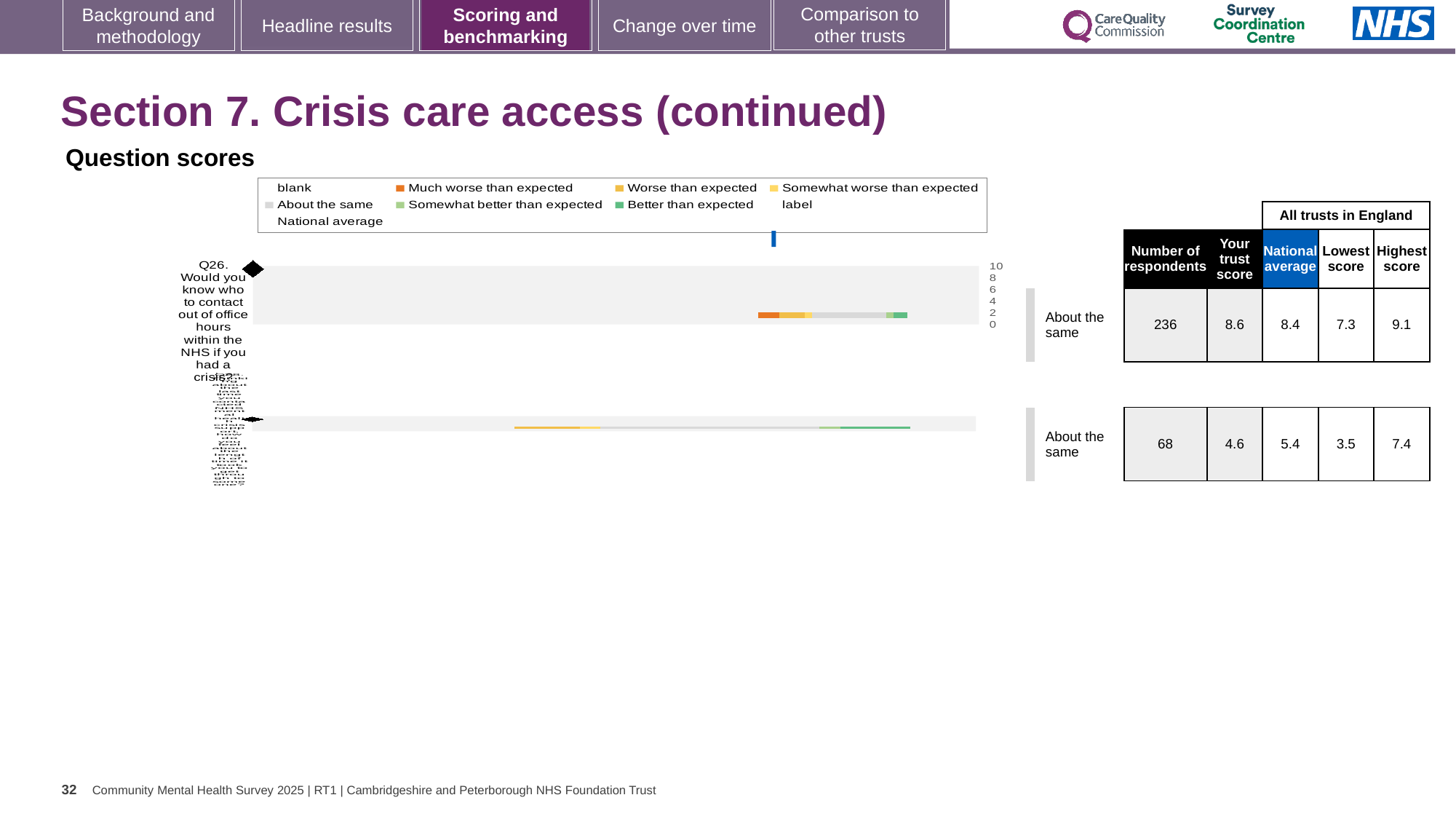
What is the highest score among all trusts in England for Q26? 9.1 For Q26, what is the difference between the highest score and the lowest score among all trusts in England? 1.8 What is the lowest score among all trusts in England for Q26? 7.3 For Q26, which is larger: the trust score or the national average? the trust score In the 'Question scores' chart legend, which colour represents 'Much worse than expected'? orange What benchmark category is shown for Q26 (Would you know who to contact out of office hours within the NHS if you had a crisis?)? About the same How many respondents answered Q26 (Would you know who to contact out of office hours within the NHS if you had a crisis?)? 236 What is the national average for Q26 (Would you know who to contact out of office hours within the NHS if you had a crisis?)? 8.4 What kind of chart is shown under the heading 'Question scores'? bar chart What is the trust score for Q26 (Would you know who to contact out of office hours within the NHS if you had a crisis?)? 8.6 How many question rows are plotted in the 'Question scores' chart? 2 In the 'Question scores' chart legend, which colour represents 'Better than expected'? green